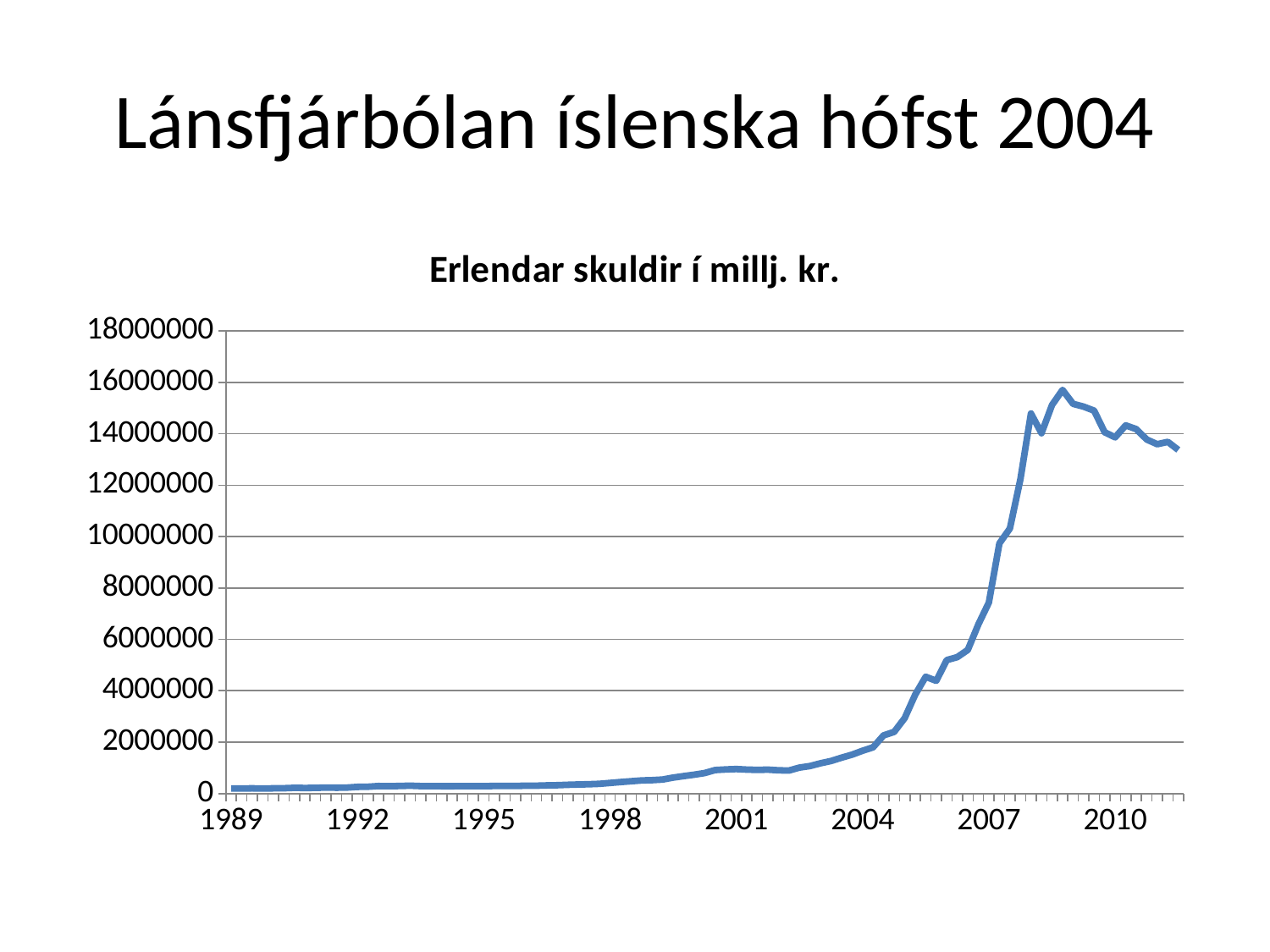
Is the value at 1989 greater or less than 2000000? less Does the line peak before or after 2007? after What kind of chart is shown on the slide? line chart Which is larger, the value at 2001 or the value at 2007? 2007 What is the highest value shown on the vertical axis? 18000000 Is the peak value of the line greater or less than 16000000? less How many lines (data series) are plotted on the chart? 1 What is the title of the chart? Erlendar skuldir í millj. kr. Does the line rise or fall between 2004 and 2008? rise Is the value at 2010 greater or less than 12000000? greater